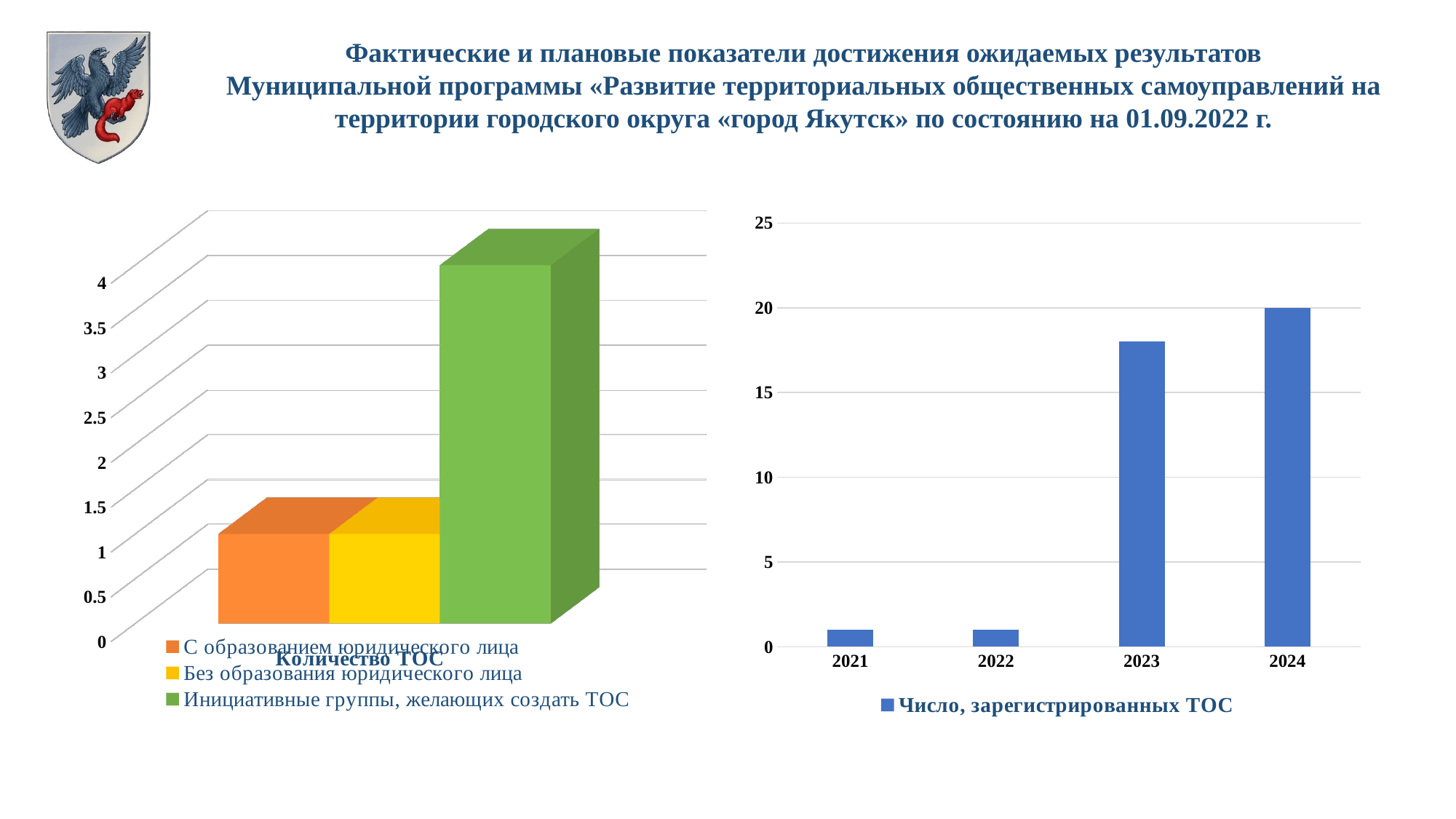
On the right chart, what is the name of the series in the legend? Число, зарегистрированных ТОС On the right chart, is the value for 2023 greater or less than 15? greater On the right chart, how many years are shown on the x axis? 4 On the right chart, do the values generally rise or fall from 2021 to 2024? rise On the right chart, what kind of chart is shown? bar chart On the right chart, what is the value for 2024? 20 On the left chart, which series has the highest value? Инициативные группы, желающих создать ТОС On the right chart, is the value for 2021 greater or less than 5? less On the right chart, which is larger: the value for 2022 or the value for 2023? 2023 On the left chart, how many series does the legend list? 3 On the right chart, which year has the highest number of registered ТОС? 2024 On the left chart, is the value for «Инициативные группы, желающих создать ТОС» greater or less than 3? greater